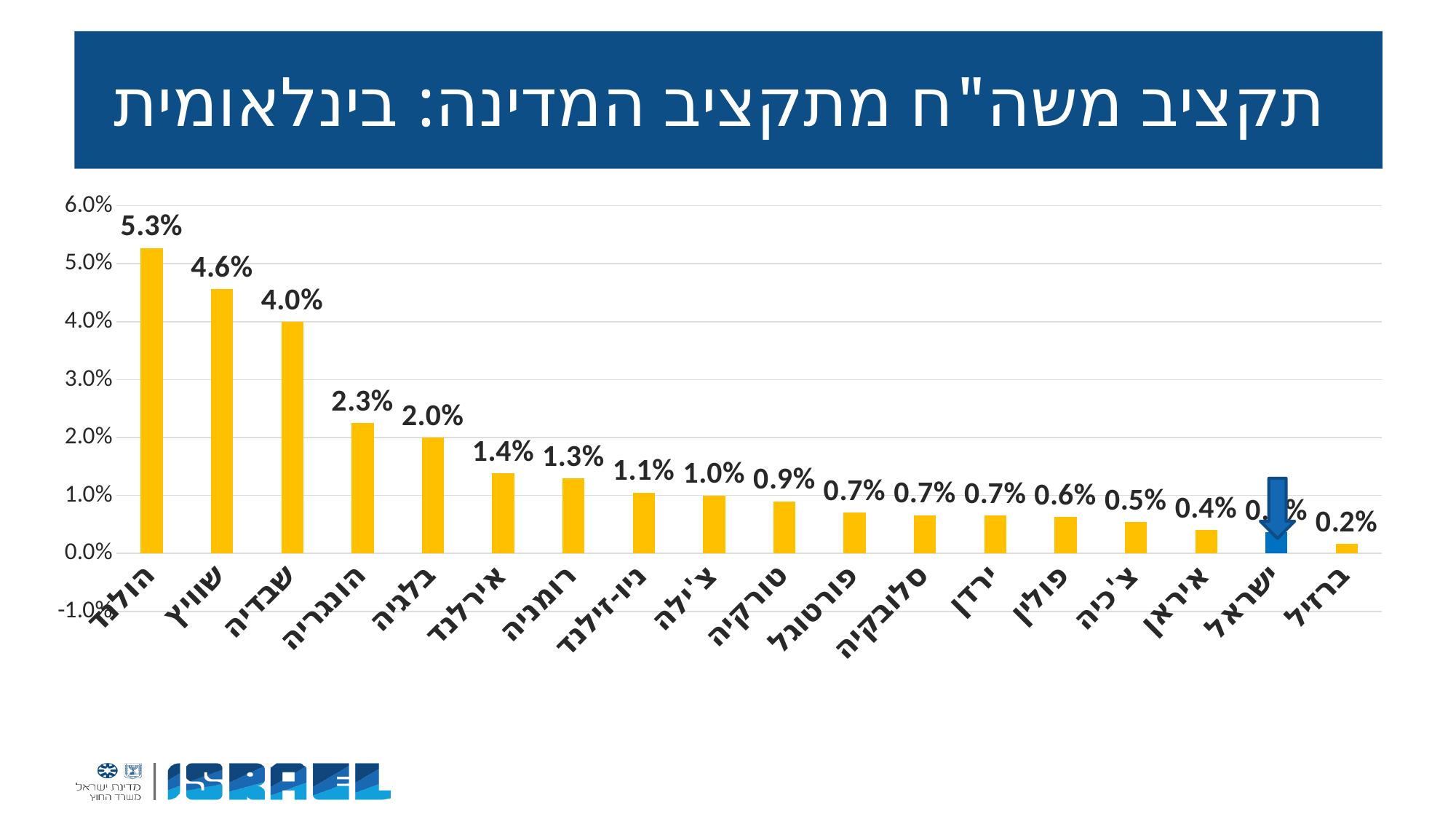
Which category has the lowest value? ברזיל (Brazil) What kind of chart is shown on the slide? bar chart What value is shown for הולנד (Netherlands)? 5.3% What is the difference between the values for הולנד (Netherlands) and שוויץ (Switzerland)? 0.7% Is the value for ישראל (Israel) greater or less than 1.0%? less Which category has the highest value? הולנד (Netherlands) What value is shown for ברזיל (Brazil)? 0.2% What value is shown for בלגיה (Belgium)? 2.0% What value is shown for שבדיה (Sweden)? 4.0% Which is larger, the value for הונגריה (Hungary) or the value for אירלנד (Ireland)? הונגריה (Hungary) How many categories are plotted on the chart? 18 Which bar is coloured blue instead of yellow? ישראל (Israel)